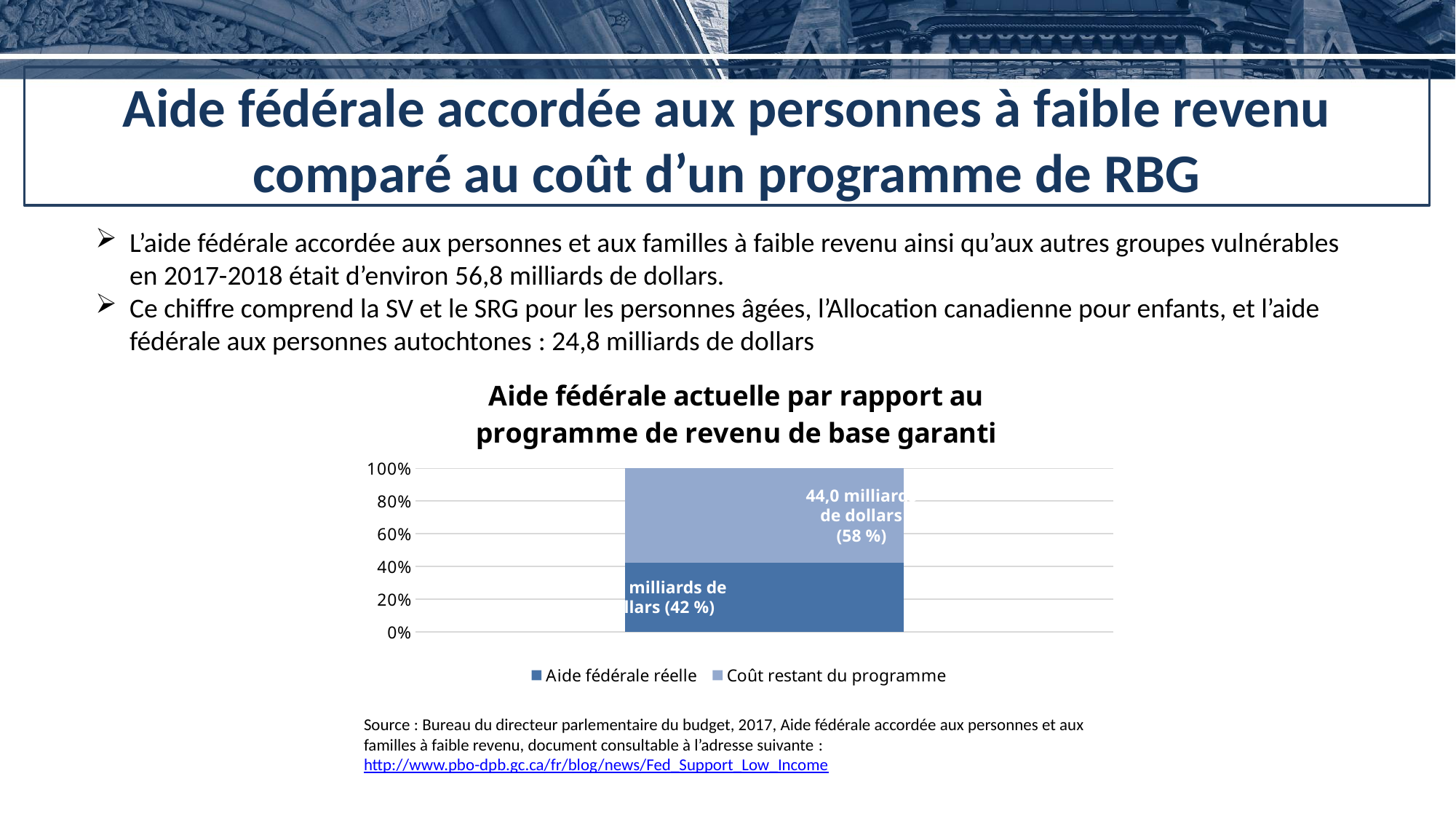
What is the title of the chart? Aide fédérale actuelle par rapport au programme de revenu de base garanti What kind of chart is shown on the slide? Stacked bar chart What is the difference in percentage points between the 'Coût restant du programme' share and the 'Aide fédérale réelle' share? 16 percentage points How many bars are plotted in the chart? 1 Which segment is larger, 'Aide fédérale réelle' or 'Coût restant du programme'? Coût restant du programme Is the share for 'Aide fédérale réelle' greater or less than 60%? less What percentage share is shown for 'Coût restant du programme'? 58 % What are the two legend entries of the chart? Aide fédérale réelle; Coût restant du programme What dollar amount is labelled on the 'Coût restant du programme' segment? 44,0 milliards de dollars Which series takes up the largest share of the bar? Coût restant du programme How many series does the chart legend list? 2 What percentage share is shown for 'Aide fédérale réelle'? 42 %